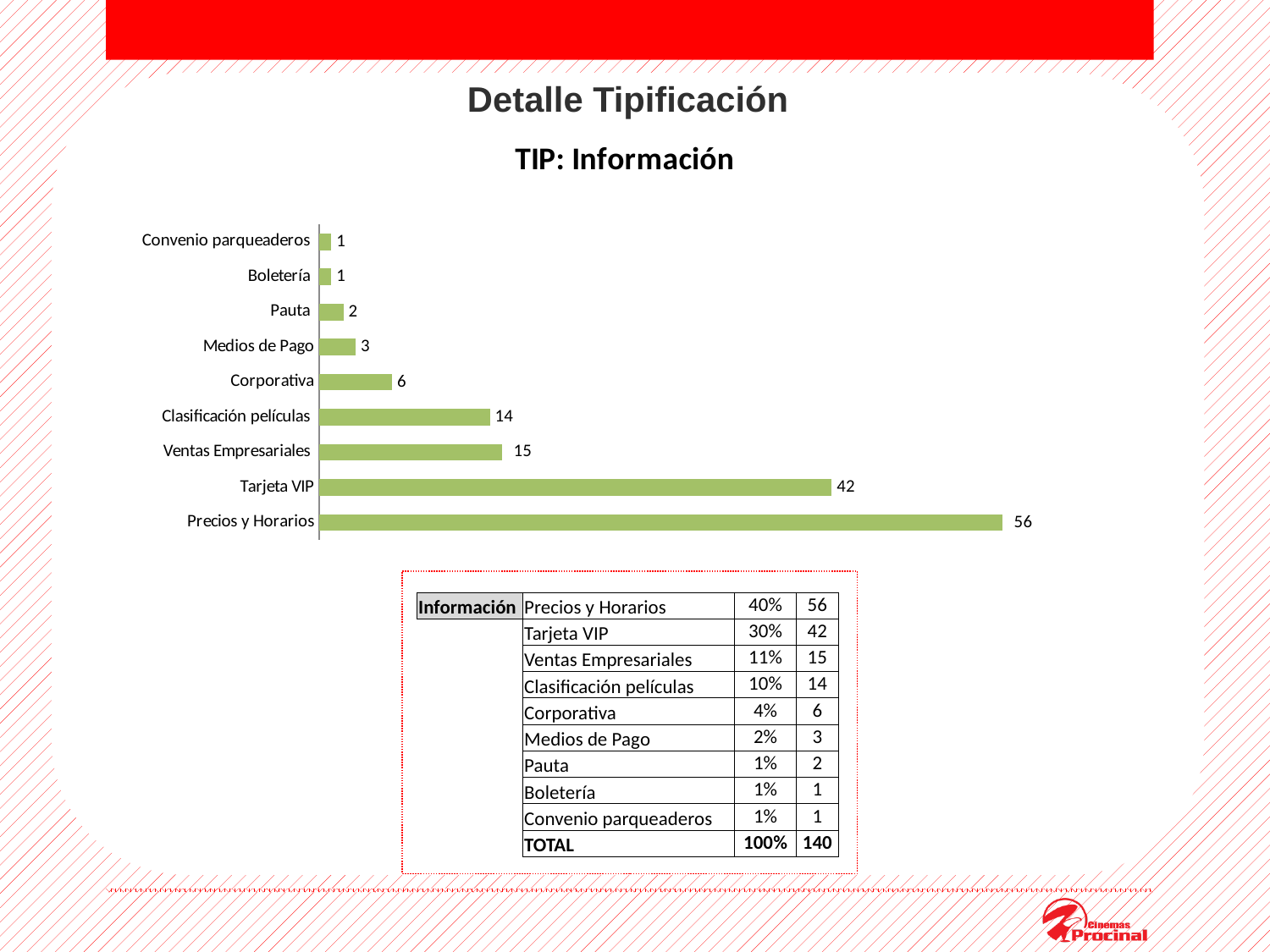
What kind of chart is shown on the slide? bar chart What is the value for Medios de Pago? 3 Which category has the highest value? Precios y Horarios What is the total of all the values shown in the chart? 140 How many categories are shown in the chart? 9 What is the value for Precios y Horarios? 56 Which is larger, the value for Ventas Empresariales or the value for Clasificación películas? Ventas Empresariales What is the difference between the values for Precios y Horarios and Tarjeta VIP? 14 What is the difference between the values for Ventas Empresariales and Corporativa? 9 What is the value for Tarjeta VIP? 42 What is the value for Clasificación películas? 14 What colour are the bars in the chart? green